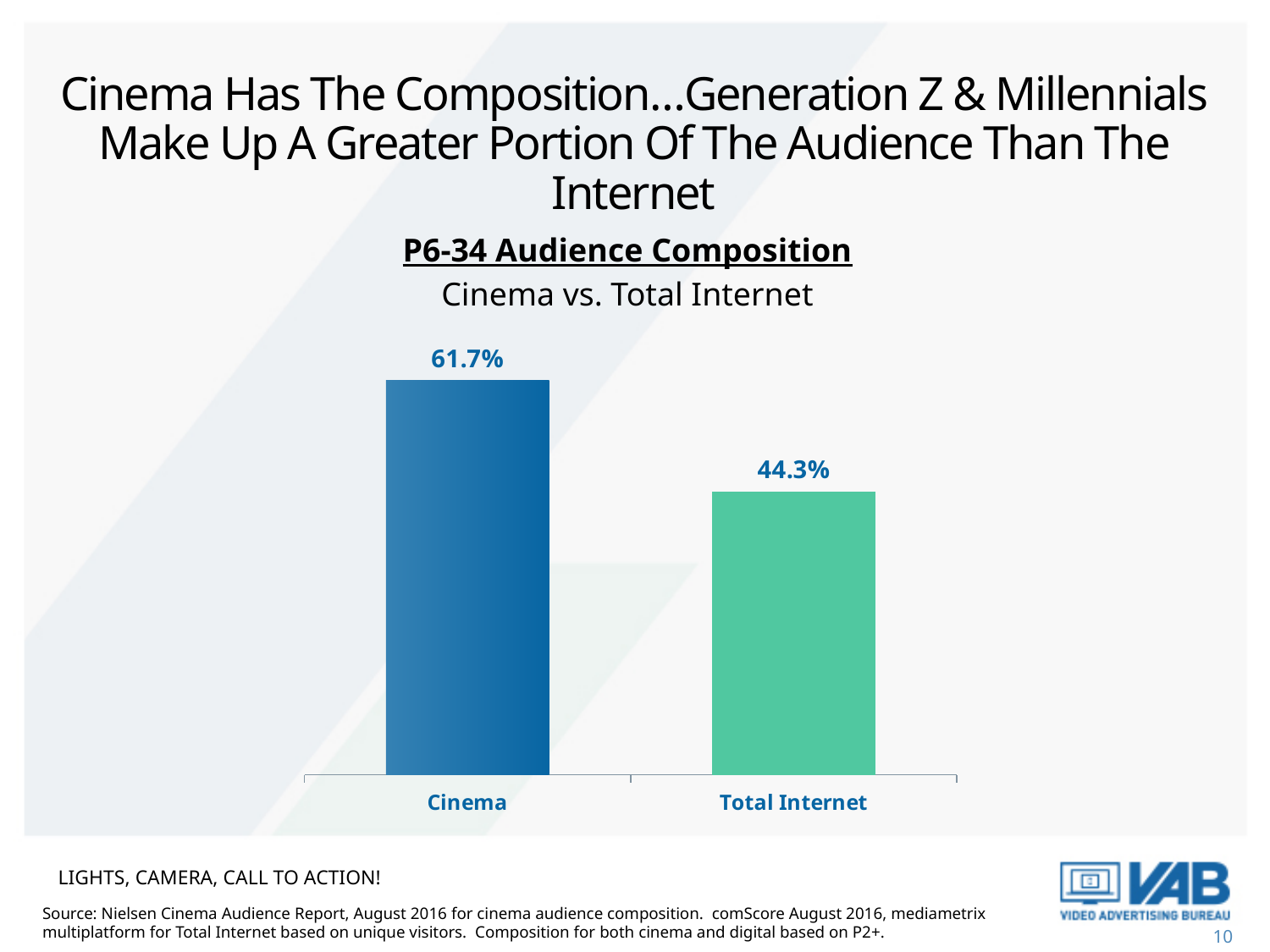
Is the value for Cinema larger or smaller than the value for Total Internet? larger What kind of chart is shown on the slide? bar chart What is the difference in percentage points between the Cinema and Total Internet values? 17.4 Which category has the lower P6-34 audience composition? Total Internet Which category has the higher P6-34 audience composition? Cinema What is the P6-34 audience composition value for Cinema? 61.7% What is the P6-34 audience composition value for Total Internet? 44.3% What is the subtitle shown under the chart title? Cinema vs. Total Internet What is the title of the chart? P6-34 Audience Composition How many categories are shown in the chart? 2